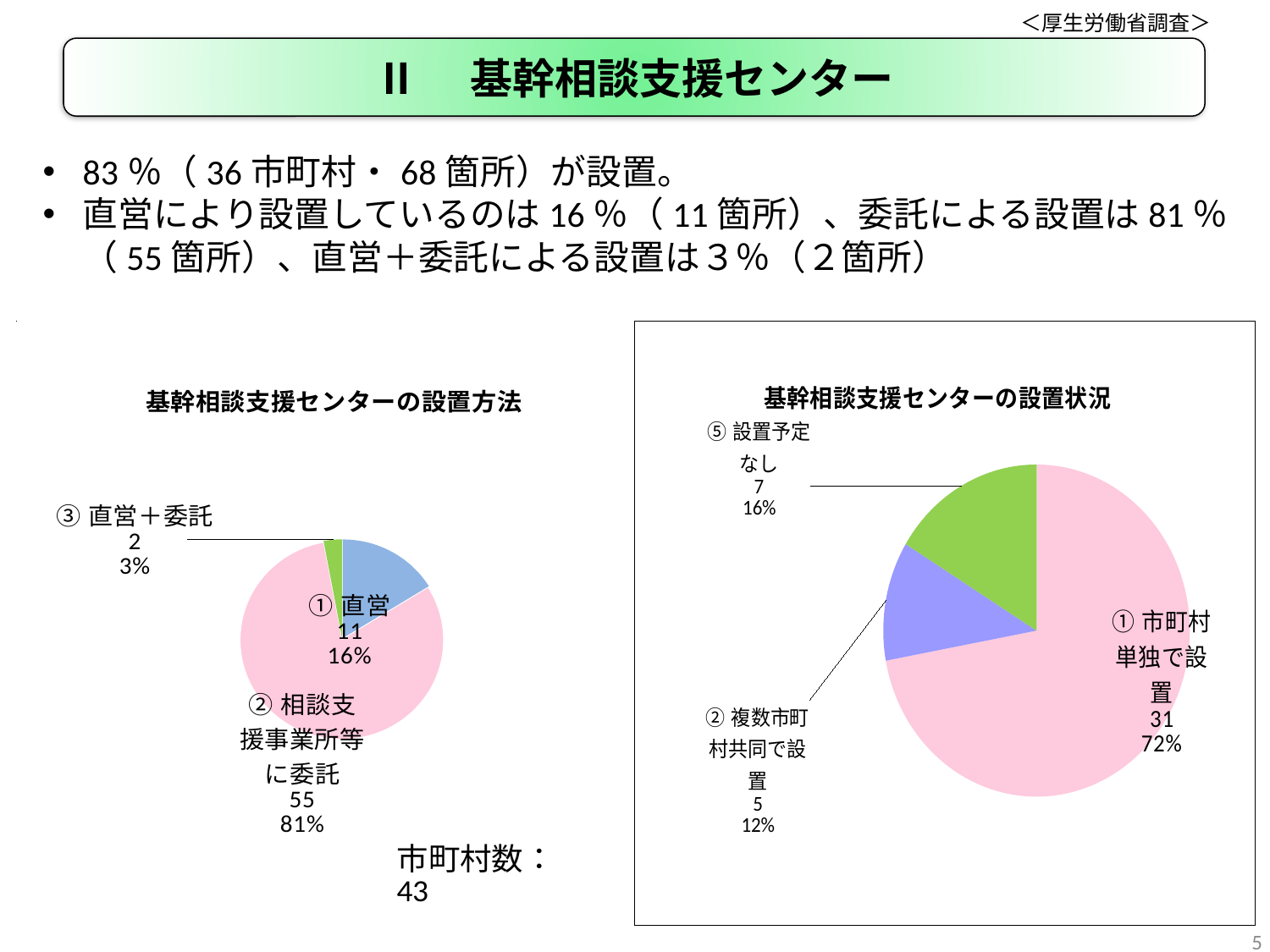
「基幹相談支援センターの設置状況」のグラフで、「① 市町村単独で設置」と「② 複数市町村共同で設置」の値の差はいくつですか？ 26 「基幹相談支援センターの設置方法」のグラフは、どの種類のグラフですか？ 円グラフ 「基幹相談支援センターの設置状況」のグラフで、「② 複数市町村共同で設置」と「⑤ 設置予定なし」では、どちらの値が大きいですか？ ⑤ 設置予定なし 「基幹相談支援センターの設置方法」のグラフで、「② 相談支援事業所等に委託」の割合は何％ですか？ 81% 「基幹相談支援センターの設置方法」のグラフで、最も値が小さい項目はどれですか？ ③ 直営＋委託 「基幹相談支援センターの設置状況」のグラフで、最も値が大きい項目はどれですか？ ① 市町村単独で設置 「基幹相談支援センターの設置状況」のグラフで、「① 市町村単独で設置」の値はいくつですか？ 31 「基幹相談支援センターの設置方法」のグラフには、いくつの項目がありますか？ 3 「基幹相談支援センターの設置方法」のグラフで、「① 直営」の値はいくつですか？ 11 「基幹相談支援センターの設置状況」のグラフで、「⑤ 設置予定なし」の割合は何％ですか？ 16% 「基幹相談支援センターの設置状況」のグラフで、「⑤ 設置予定なし」の扇形は何色ですか？ 緑 「基幹相談支援センターの設置方法」のグラフで、「② 相談支援事業所等に委託」と「① 直営」の値の差はいくつですか？ 44